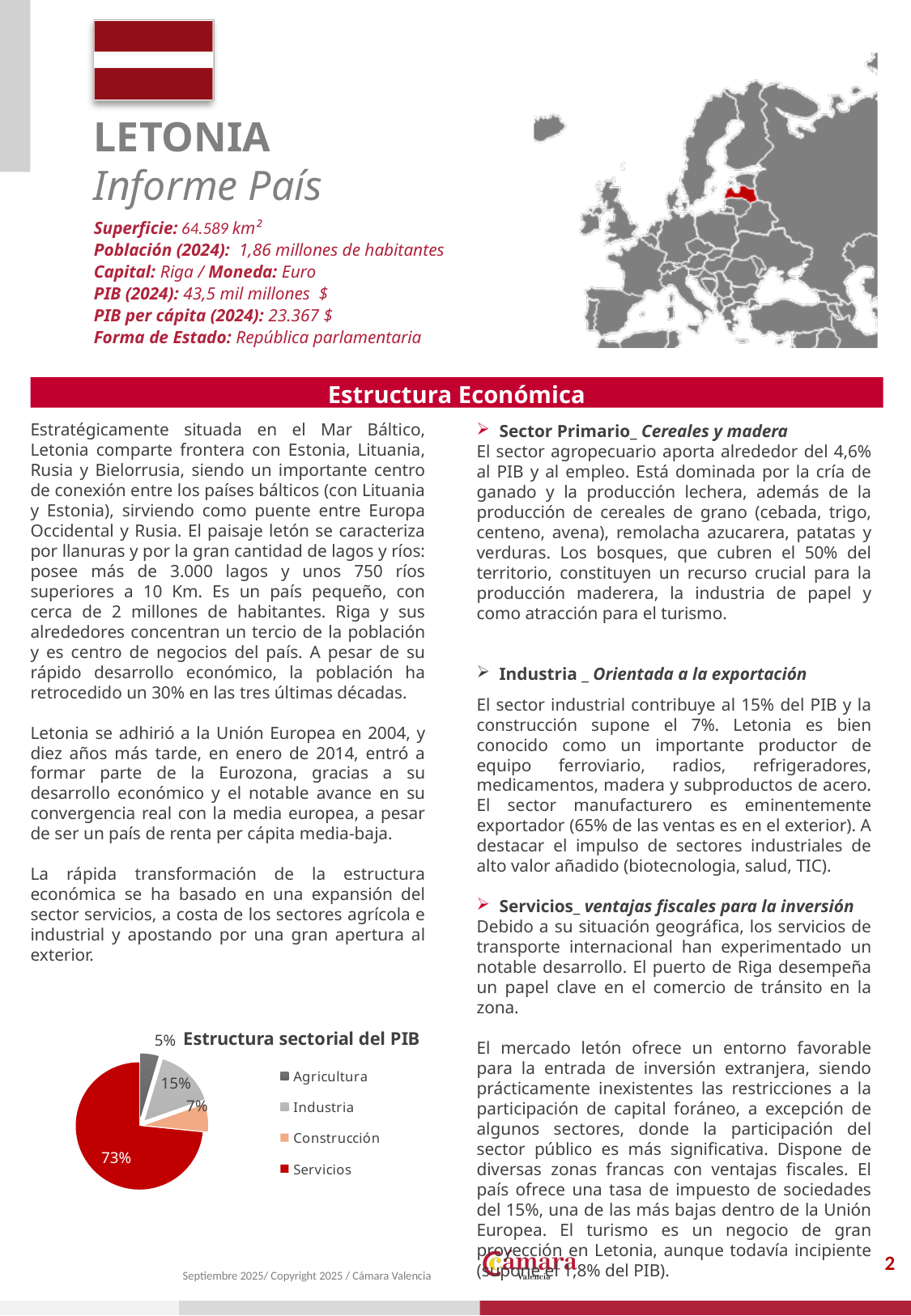
In the "Estructura sectorial del PIB" chart, what share does Construcción have? 7% Which sector has the largest slice in the "Estructura sectorial del PIB" chart? Servicios Which sector has the smallest slice in the "Estructura sectorial del PIB" chart? Agricultura How many slices does the "Estructura sectorial del PIB" pie chart have? 4 What kind of chart is "Estructura sectorial del PIB"? pie chart In the "Estructura sectorial del PIB" chart, which is larger, Industria or Construcción? Industria What colour is the Servicios slice in the "Estructura sectorial del PIB" chart? red In the "Estructura sectorial del PIB" chart, what share does Agricultura have? 5% In the "Estructura sectorial del PIB" chart, what share does Servicios have? 73% How many entries does the legend of the "Estructura sectorial del PIB" chart list? 4 In the "Estructura sectorial del PIB" chart, what share does Industria have? 15% In the "Estructura sectorial del PIB" chart, what is the difference between the Servicios and Industria shares? 58%